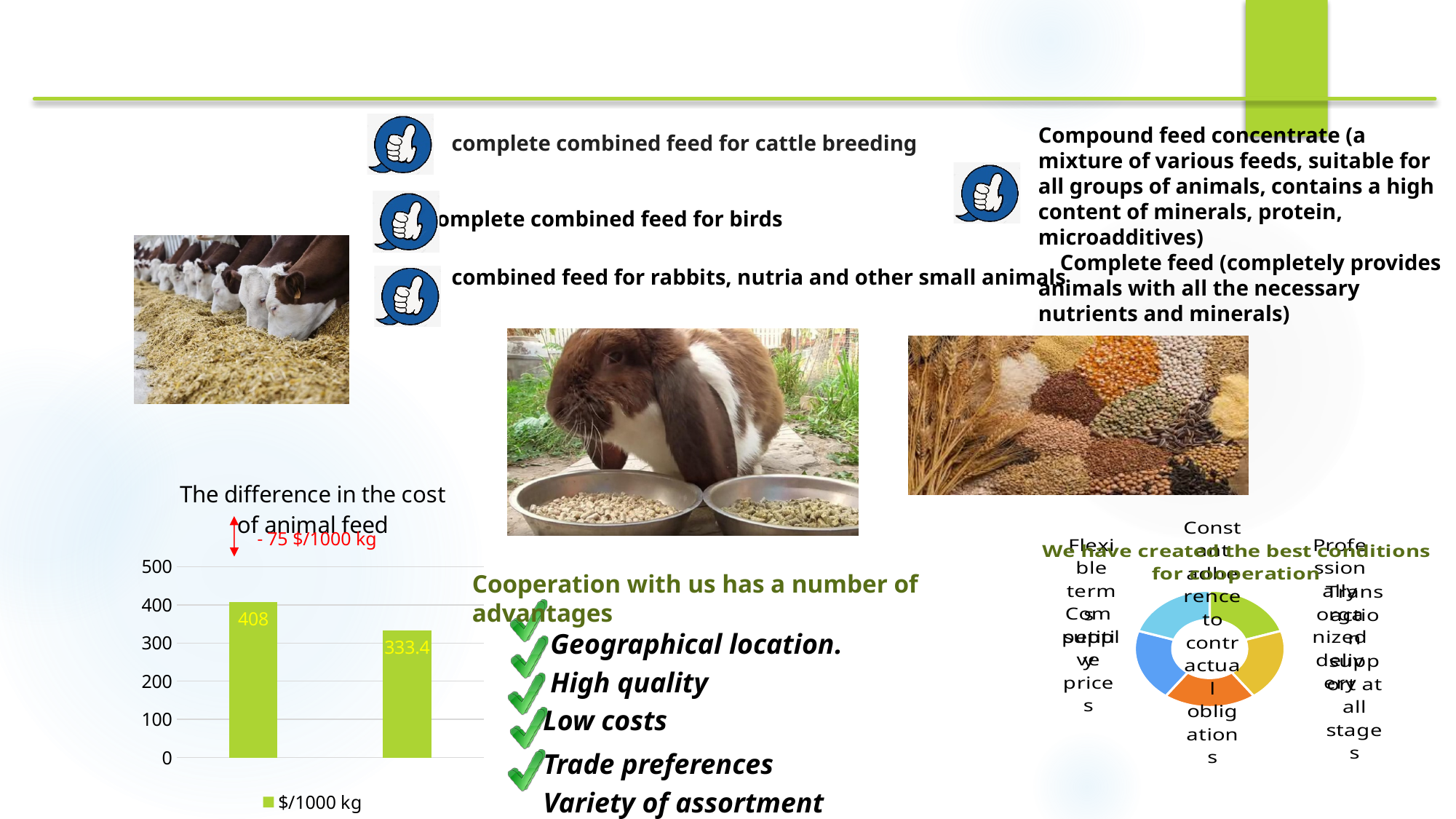
What is the legend entry of the chart 'The difference in the cost of animal feed'? $/1000 kg In the chart 'The difference in the cost of animal feed', is the value of the right bar greater or less than 400? less In the chart 'The difference in the cost of animal feed', do the values rise or fall from left to right? fall In the chart 'The difference in the cost of animal feed', what is the value of the left bar? 408 In the chart 'The difference in the cost of animal feed', what is the highest value shown on a bar? 408 What kind of chart is 'The difference in the cost of animal feed'? bar chart In the chart 'The difference in the cost of animal feed', what is the difference between the left bar (408) and the right bar (333.4)? 74.6 In the chart 'The difference in the cost of animal feed', how many bars are plotted? 2 In the chart 'The difference in the cost of animal feed', what is the value of the right bar? 333.4 In the chart 'The difference in the cost of animal feed', what is the lowest value shown on a bar? 333.4 How many series does the legend of the chart 'The difference in the cost of animal feed' list? 1 In the chart 'The difference in the cost of animal feed', which bar is taller, the left one or the right one? the left one